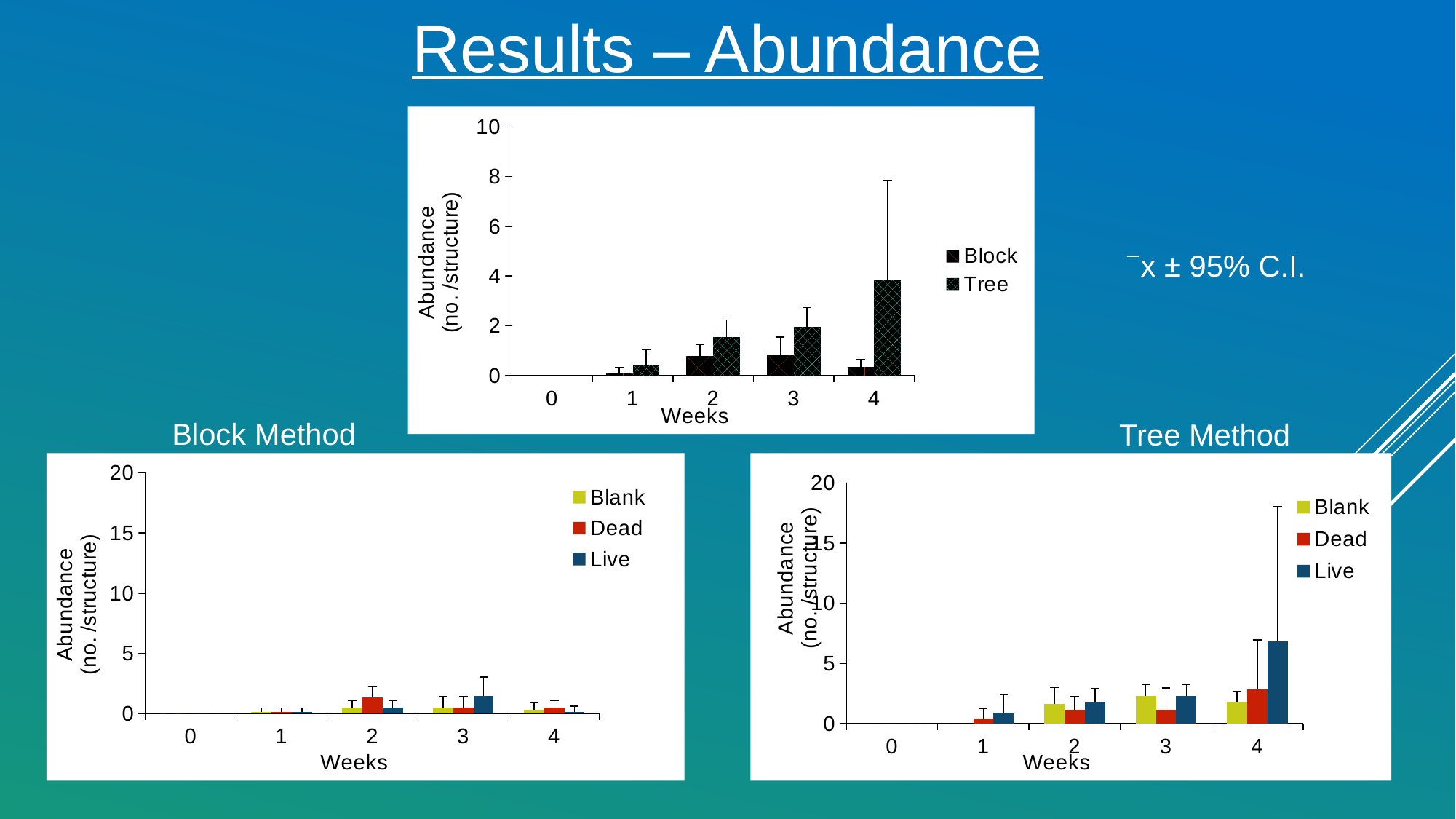
In the top chart, how many series does the legend list? 2 In the top chart, is the Block value at week 4 greater or less than 2? less In the Tree Method chart, is the Live value at week 4 greater or less than 5? greater In the top chart, at which week is the Tree value highest? 4 In the top chart, does the Tree series rise or fall from week 1 to week 4? rise In the top chart, which is larger at week 4, Block or Tree? Tree In the top chart, is the Tree value at week 4 greater or less than 2? greater In the Block Method chart, how many series does the legend list? 3 What kind of chart is the top chart comparing Block and Tree? bar chart In the top chart, how many week categories are shown on the x axis? 5 In the Tree Method chart, which is larger at week 3, Blank or Dead? Blank In the Tree Method chart, which series has the highest bar at week 4? Live